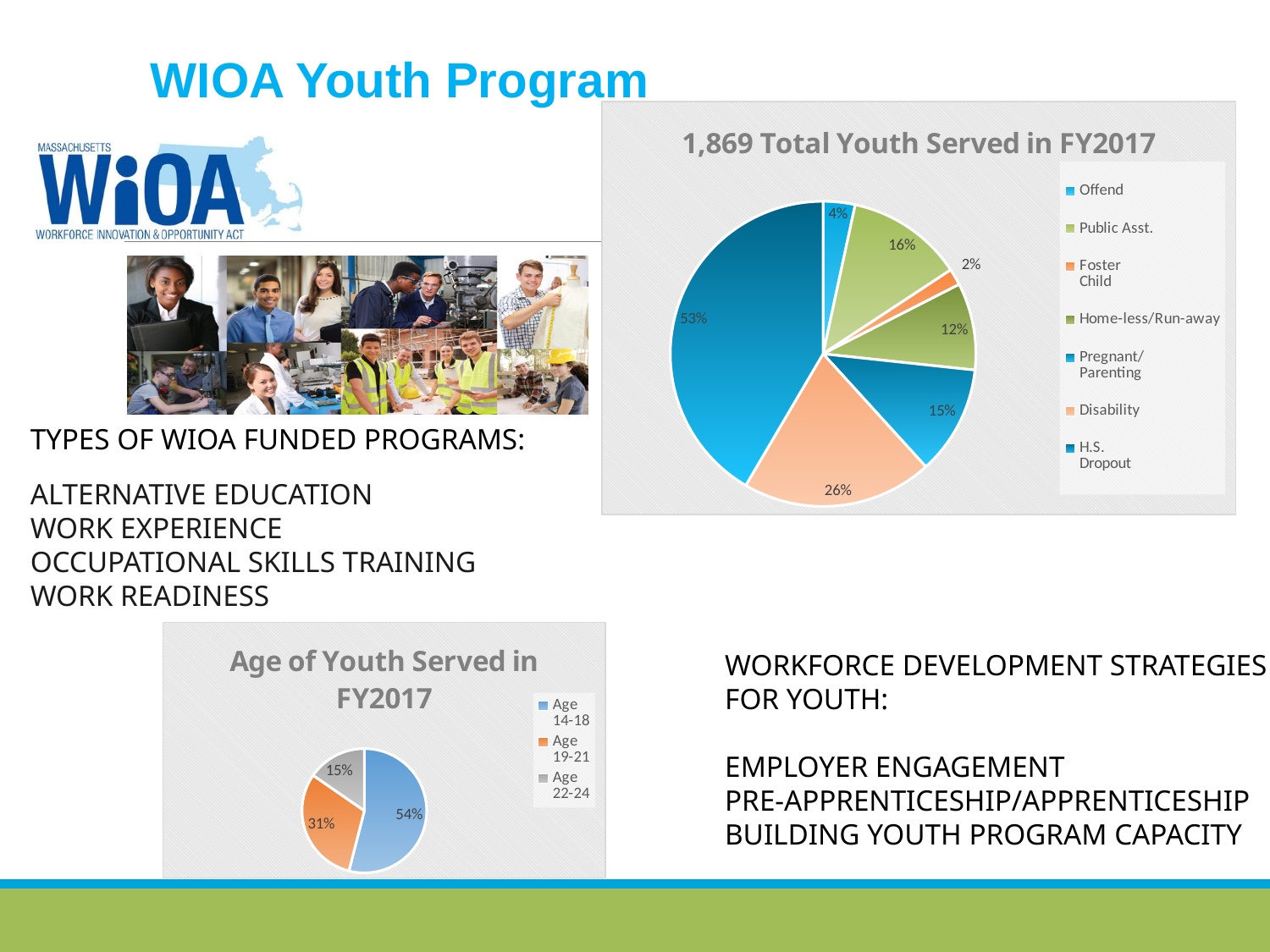
In the 'Age of Youth Served in FY2017' chart, what is the difference between the Age 14-18 and Age 22-24 shares? 39% In the '1,869 Total Youth Served in FY2017' chart, how many categories does the legend list? 7 In the '1,869 Total Youth Served in FY2017' chart, which category has the smallest slice? Foster Child In the 'Age of Youth Served in FY2017' chart, which age group has the largest share? Age 14-18 In the '1,869 Total Youth Served in FY2017' chart, which category has the largest slice? H.S. Dropout In the '1,869 Total Youth Served in FY2017' chart, what percentage is shown for Disability? 26% In the '1,869 Total Youth Served in FY2017' chart, what is the difference between the Disability and Offend percentages? 22% In the 'Age of Youth Served in FY2017' chart, what percentage is shown for Age 19-21? 31% In the '1,869 Total Youth Served in FY2017' chart, which is larger, Pregnant/Parenting or Home-less/Run-away? Pregnant/Parenting In the '1,869 Total Youth Served in FY2017' chart, what percentage is shown for H.S. Dropout? 53% What kind of chart is 'Age of Youth Served in FY2017'? Pie chart In the '1,869 Total Youth Served in FY2017' chart, what percentage is shown for Public Asst.? 16%